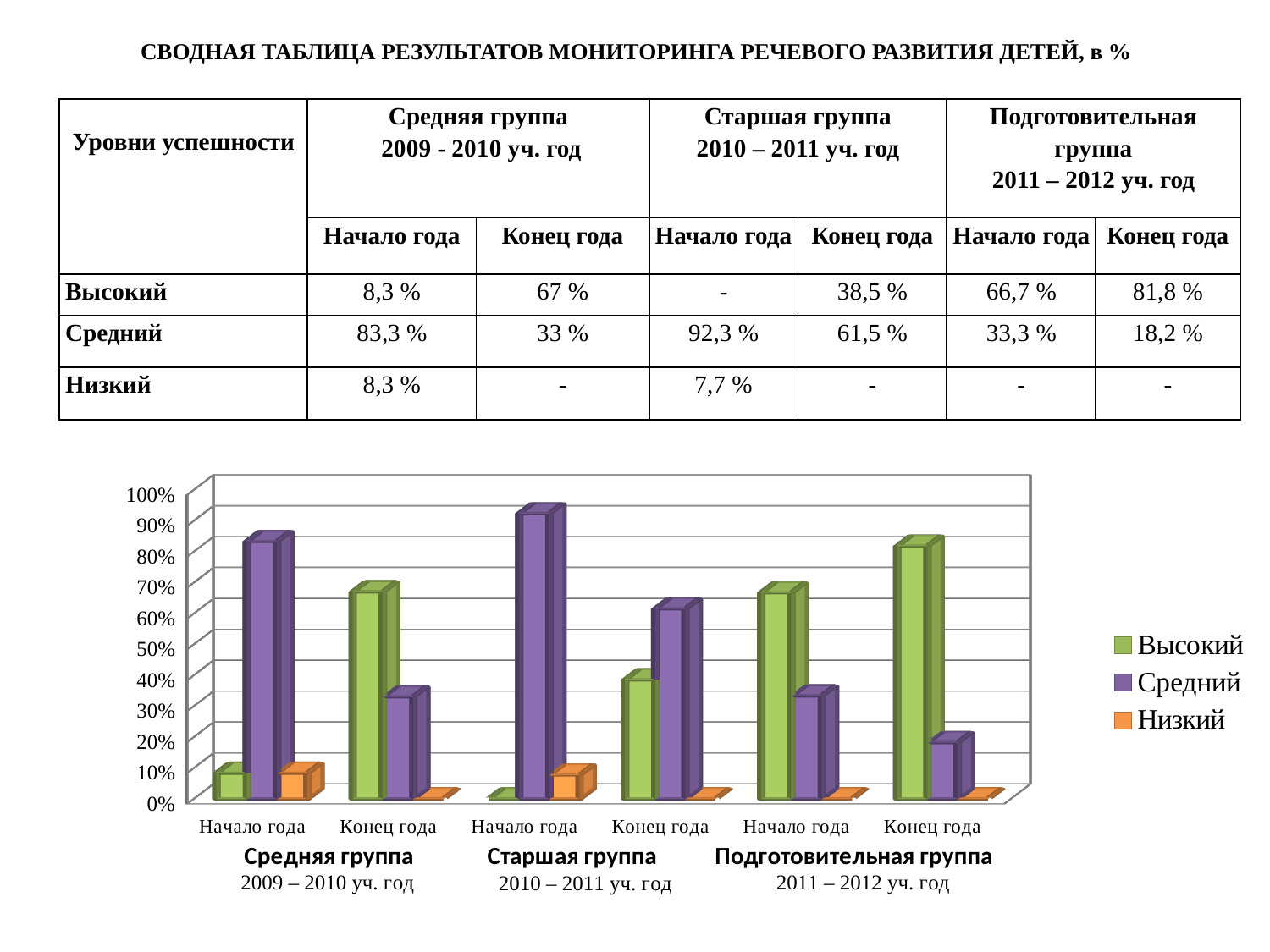
Is the Высокий value for Подготовительная группа, Конец года greater or less than 70%? greater What kind of chart is shown on the slide? bar chart What is the Высокий value for Средняя группа, Конец года? 67 % Which colour represents the Низкий series in the chart legend? orange In which category does the Средний series reach its highest value? Старшая группа, Начало года Is the Средний value for Средняя группа, Начало года greater or less than 80%? greater For Старшая группа, Конец года, which is larger: the Высокий value or the Средний value? Средний How many categories (Начало года / Конец года groups) are plotted along the x axis of the chart? 6 What is the Средний value for Старшая группа, Начало года? 92,3 % By how much does the Высокий value for Подготовительная группа change from Начало года (66,7 %) to Конец года (81,8 %)? 15,1 % How many series does the chart legend list? 3 Does the Средний value rise or fall from Начало года to Конец года in Подготовительная группа? fall